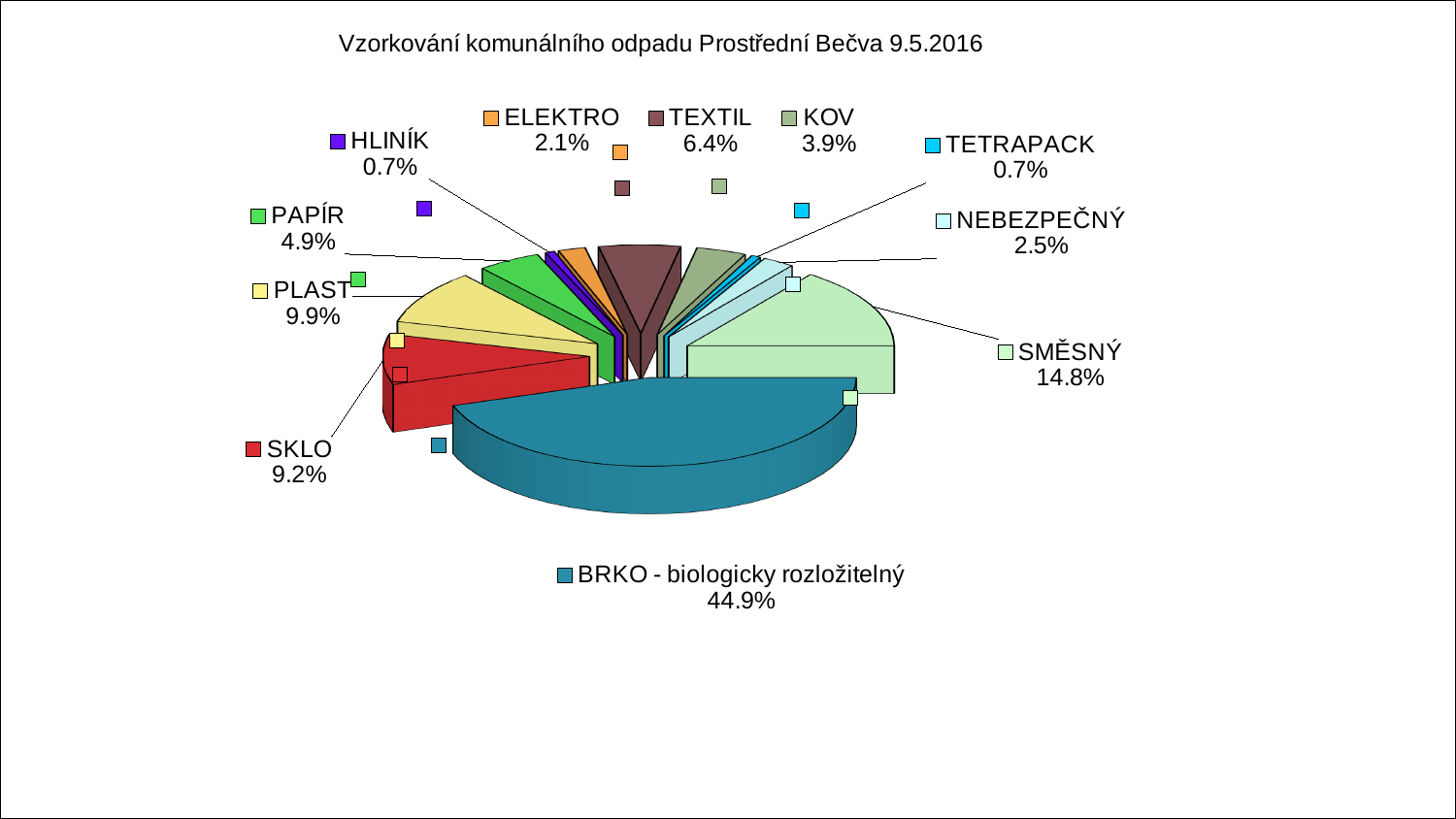
What kind of chart is shown on the slide? pie chart What is the value shown for KOV? 3.9% What is the title of the chart? Vzorkování komunálního odpadu Prostřední Bečva 9.5.2016 What is the difference between the shares of BRKO - biologicky rozložitelný and SMĚSNÝ? 30.1% Which is larger, PLAST or SKLO? PLAST How many categories (slices) does the pie chart show? 11 What is the value shown for NEBEZPEČNÝ? 2.5% What share of the pie does SMĚSNÝ have? 14.8% What is the value shown for TEXTIL? 6.4% Which category has the largest share of the pie? BRKO - biologicky rozložitelný What is the difference between the shares of SMĚSNÝ and PAPÍR? 9.9% What is the value shown for PLAST? 9.9%